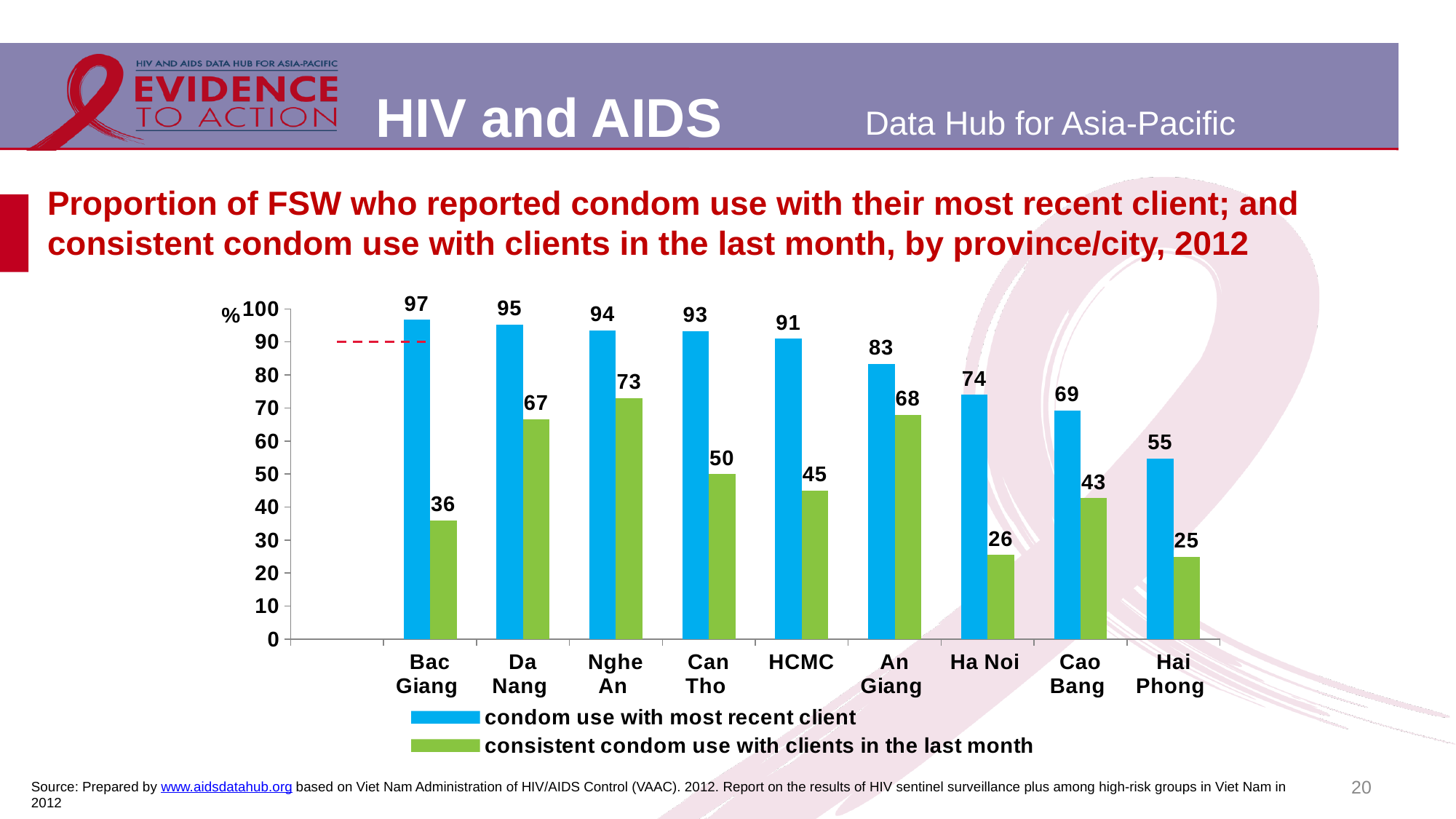
What colour are the bars for consistent condom use with clients in the last month? green Do the values for condom use with most recent client rise or fall from Bac Giang to Hai Phong? fall What is the value for consistent condom use with clients in the last month in Hai Phong? 25 Which is larger in Ha Noi: condom use with most recent client or consistent condom use with clients in the last month? condom use with most recent client How many series does the legend list? 2 Which province/city has the lowest value for consistent condom use with clients in the last month? Hai Phong What is the value for condom use with most recent client in Bac Giang? 97 What is the value for consistent condom use with clients in the last month in Nghe An? 73 What is the difference between condom use with most recent client and consistent condom use with clients in the last month in Bac Giang? 61 What kind of chart is shown on the slide? bar chart How many provinces/cities are shown on the x axis? 9 Which province/city has the highest value for condom use with most recent client? Bac Giang